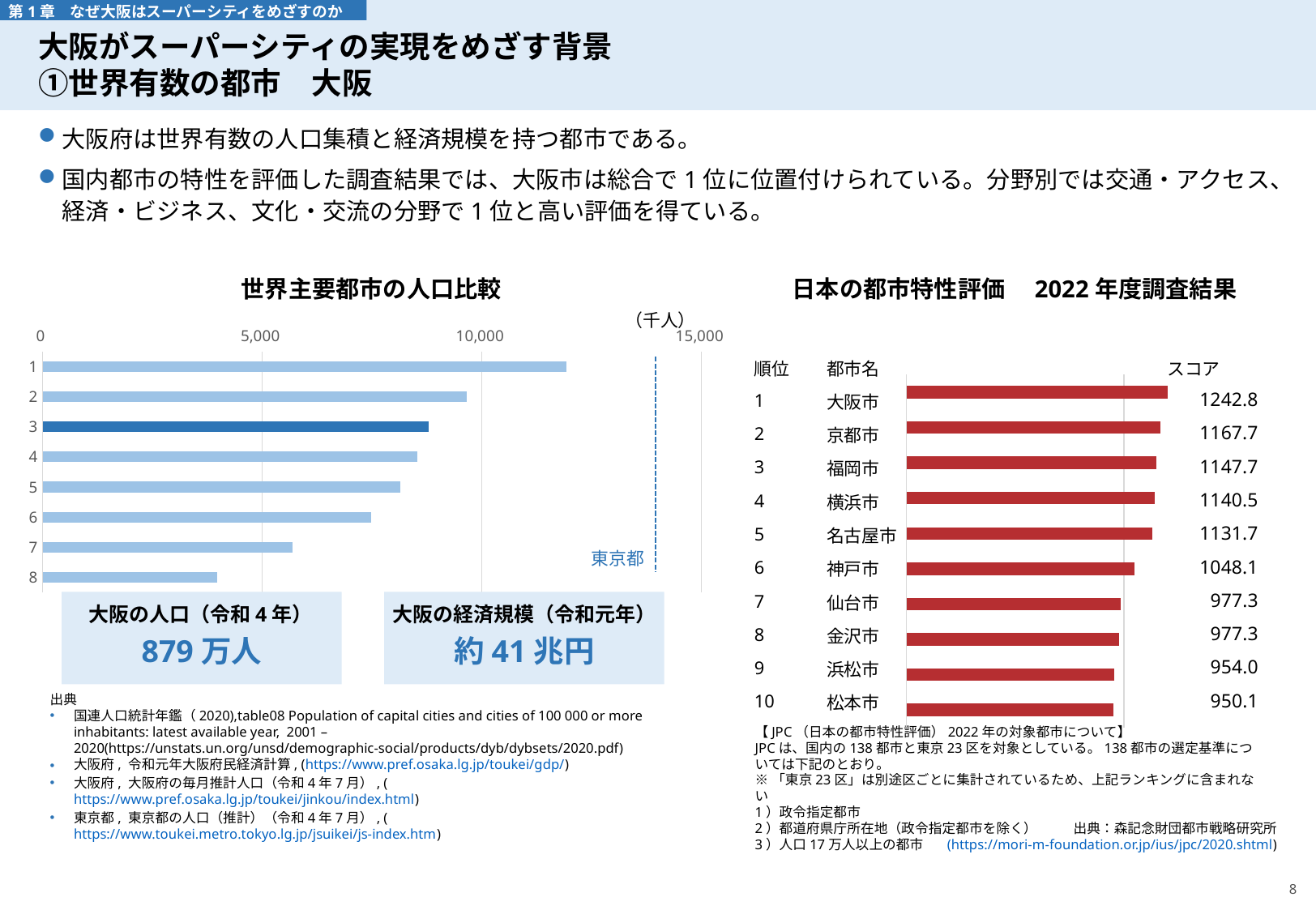
In the chart titled 世界主要都市の人口比較, how many bars (categories) are plotted? 8 In the chart titled 世界主要都市の人口比較, is the value for category 3 greater or less than 10,000? less In the chart titled 日本の都市特性評価 2022年度調査結果, how many cities are listed? 10 In the chart titled 日本の都市特性評価 2022年度調査結果, what is the score for 神戸市? 1048.1 In the chart titled 世界主要都市の人口比較, is the value for category 1 greater or less than 10,000? greater In the chart titled 世界主要都市の人口比較, is the value for category 8 greater or less than 5,000? less In the chart titled 世界主要都市の人口比較, which city is marked by the dashed vertical line near 15,000? 東京都 In the chart titled 日本の都市特性評価 2022年度調査結果, which city has the lowest score? 松本市 In the chart titled 日本の都市特性評価 2022年度調査結果, what is the difference between the scores of 大阪市 and 京都市? 75.1 In the chart titled 世界主要都市の人口比較, which category has the longest bar? 1 In the chart titled 日本の都市特性評価 2022年度調査結果, what is the score for 大阪市? 1242.8 In the chart titled 世界主要都市の人口比較, what kind of chart is it? bar chart